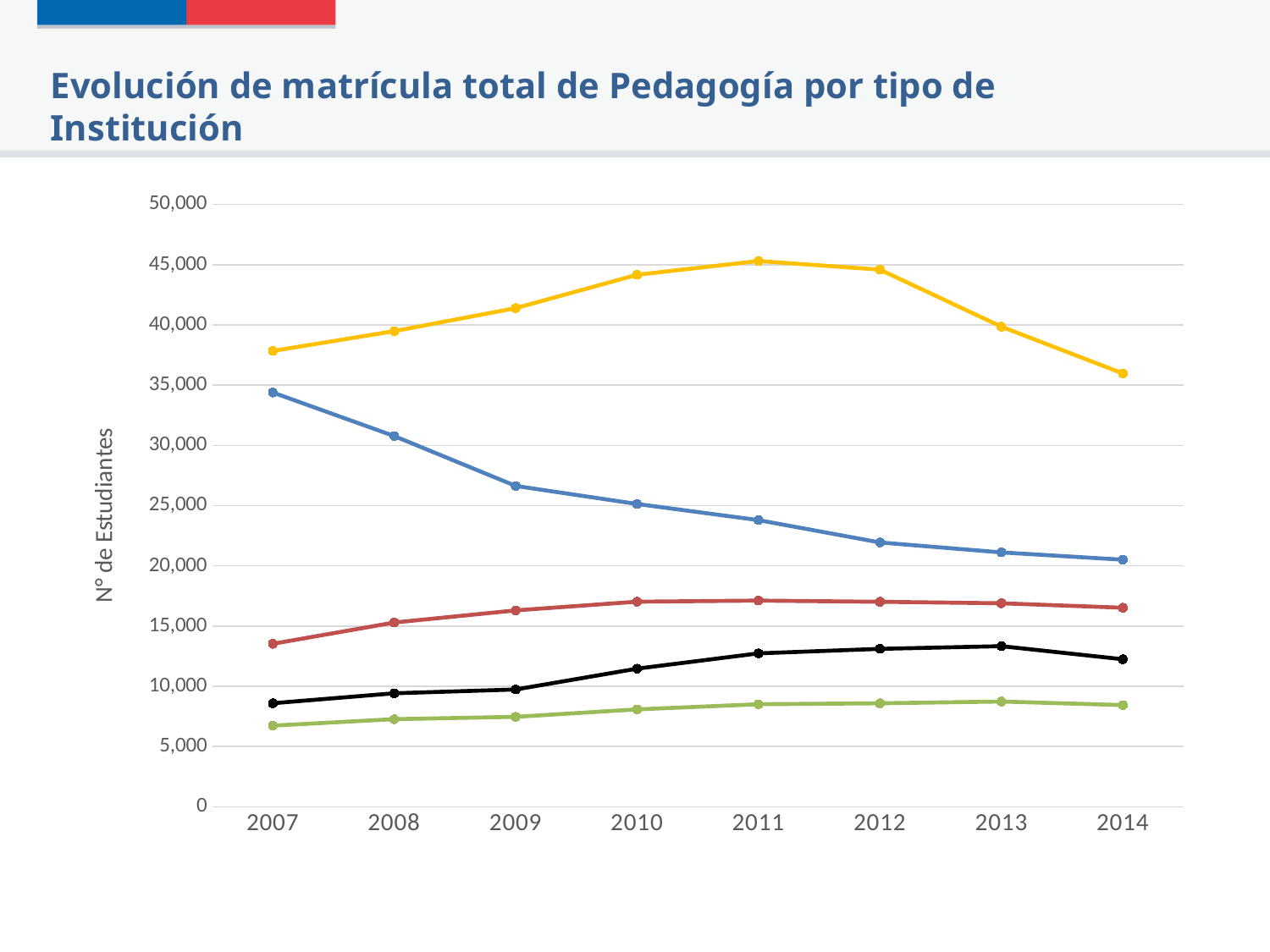
In which year does the blue line reach its lowest value? 2014 How many years are shown along the x axis? 8 Does the yellow line rise or fall from 2007 to 2011? rise What is the title of the chart on the slide? Evolución de matrícula total de Pedagogía por tipo de Institución Does the blue line rise or fall from 2007 to 2014? fall What is the label of the y axis? N° de Estudiantes Is the value of the blue line in 2007 greater or less than 30,000? greater In which year does the yellow line reach its highest value? 2011 What kind of chart is shown on the slide? line chart How many lines are plotted on the chart? 5 Is the value of the green line in 2007 greater or less than 10,000? less In 2014, which is larger: the value of the blue line or the value of the red line? the blue line